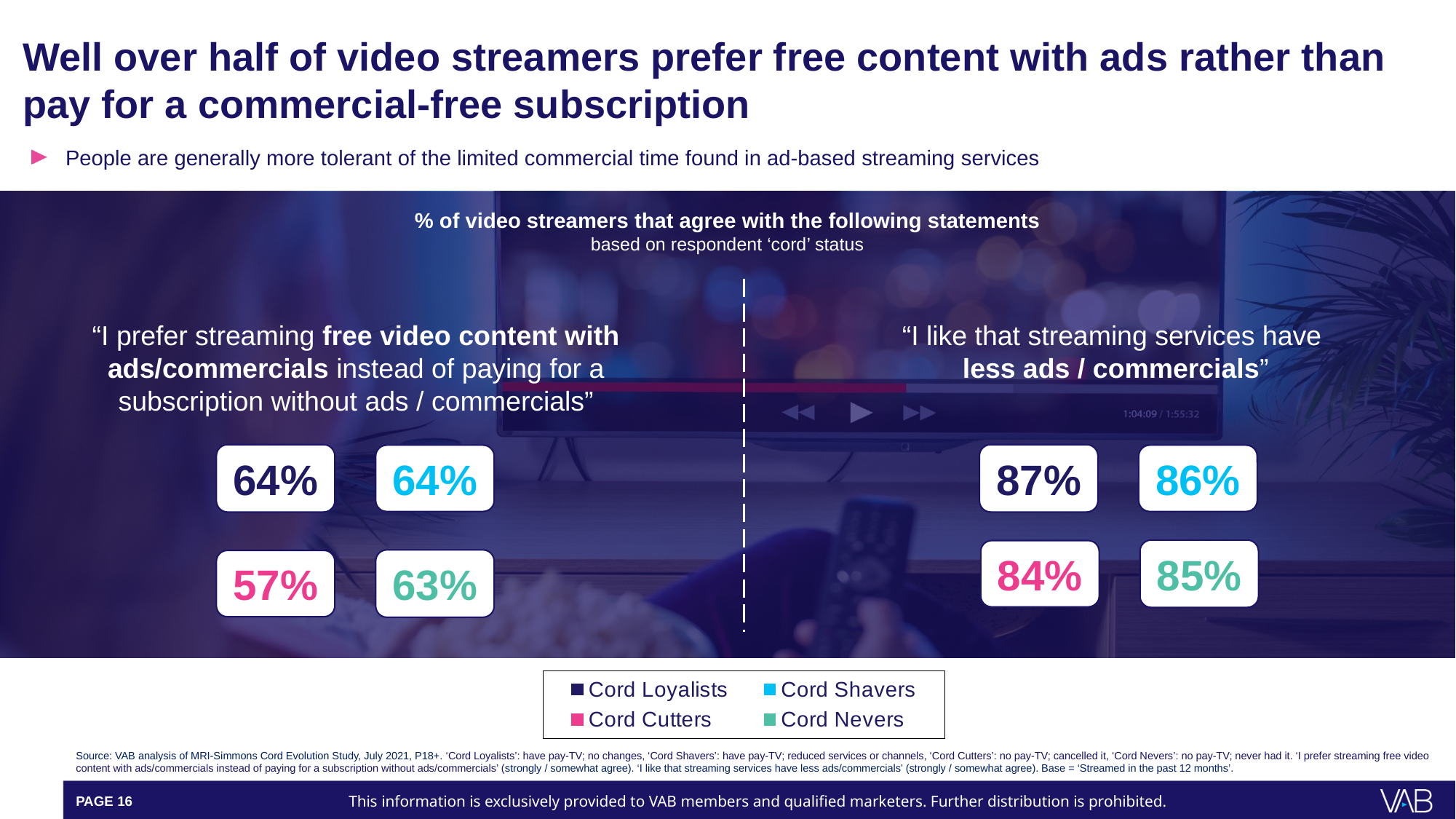
For the statement "I prefer streaming free video content with ads/commercials instead of paying for a subscription without ads / commercials", which cord status group has the lowest agreement? Cord Cutters For the statement "I prefer streaming free video content with ads/commercials instead of paying for a subscription without ads / commercials", what percentage of Cord Cutters agree? 57% For the statement "I like that streaming services have less ads / commercials", what percentage of Cord Loyalists agree? 87% For the statement "I like that streaming services have less ads / commercials", what percentage of Cord Shavers agree? 86% For the statement "I like that streaming services have less ads / commercials", which cord status group has the highest agreement? Cord Loyalists For the statement "I like that streaming services have less ads / commercials", what is the difference between the Cord Loyalists and Cord Cutters percentages? 3 percentage points For the statement "I prefer streaming free video content with ads/commercials instead of paying for a subscription without ads / commercials", what percentage of Cord Loyalists agree? 64% For the statement "I prefer streaming free video content with ads/commercials instead of paying for a subscription without ads / commercials", what is the difference between the Cord Loyalists and Cord Cutters percentages? 7 percentage points How many cord status groups does the legend list? 4 Which cord status group is shown in pink in the legend? Cord Cutters For the statement "I prefer streaming free video content with ads/commercials instead of paying for a subscription without ads / commercials", what percentage of Cord Nevers agree? 63% For the statement "I like that streaming services have less ads / commercials", what percentage of Cord Cutters agree? 84%